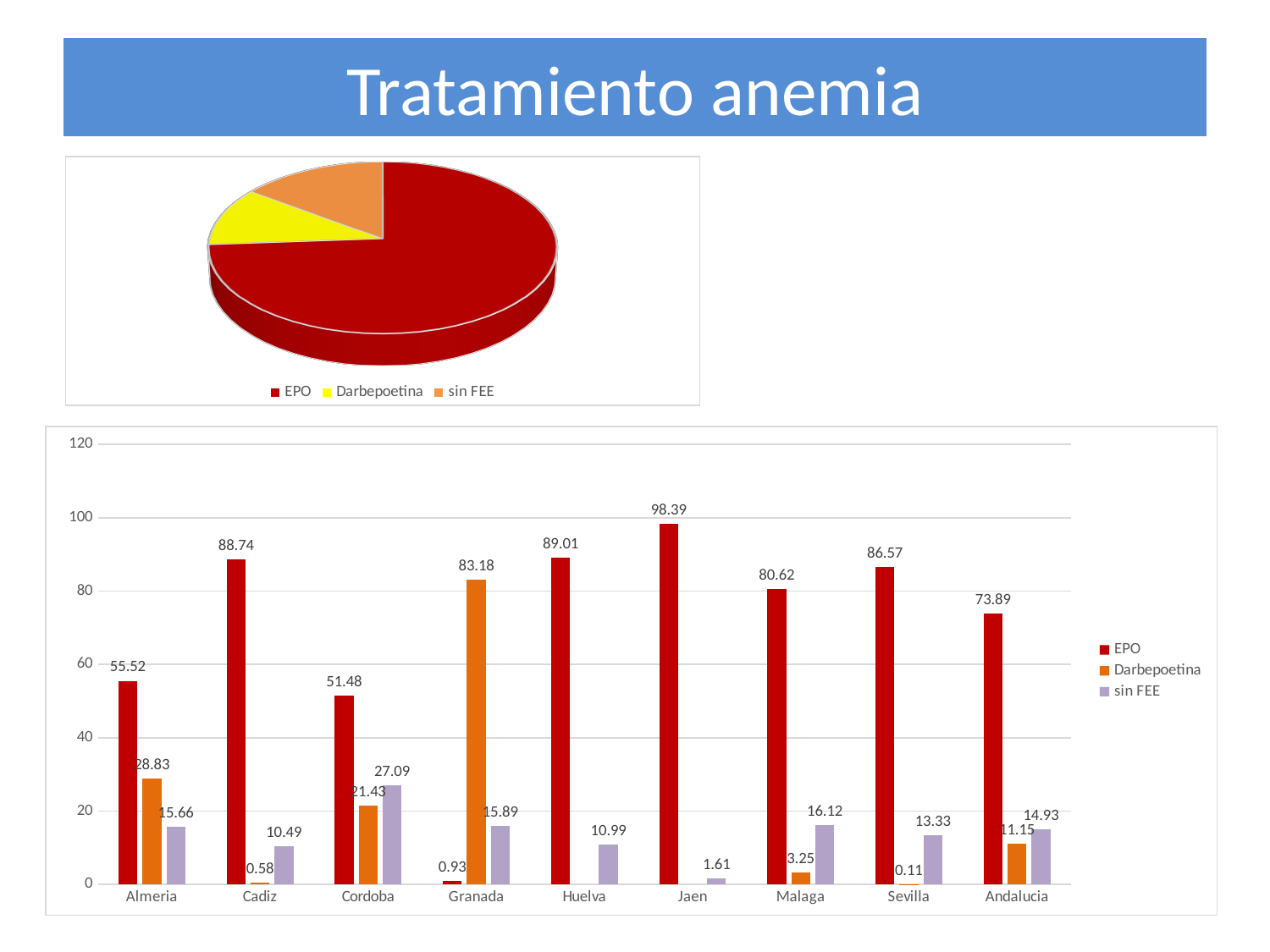
What type of chart is the bottom chart on the slide? bar chart How many categories are shown on the x axis of the bottom bar chart? 9 What type of chart is the top chart on the slide? pie chart In the bottom bar chart, which category has the lowest EPO value? Granada In the bottom bar chart, what is the EPO value for Jaen? 98.39 In the bottom bar chart, what is the Darbepoetina value for Granada? 83.18 In the bottom bar chart, which category has the highest EPO value? Jaen In the bottom bar chart, what is the sin FEE value for Cordoba? 27.09 In the top pie chart, which category has the largest slice? EPO In the bottom bar chart, what is the difference between the EPO values for Cadiz and Almeria? 33.22 How many entries does the legend of the top pie chart list? 3 In the bottom bar chart, which is larger: the sin FEE value for Malaga or the sin FEE value for Sevilla? Malaga